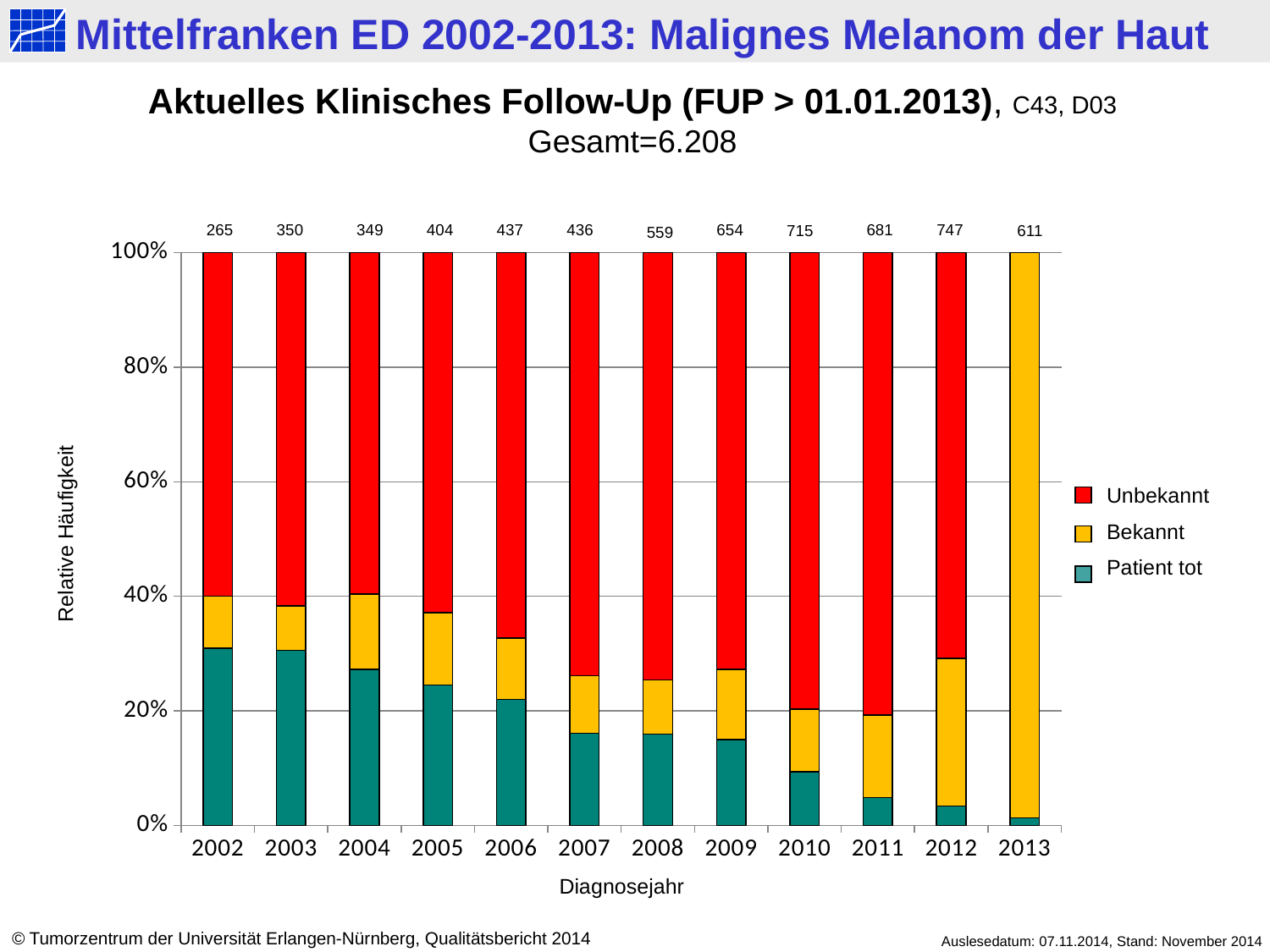
Which diagnosis year has the highest number printed above its bar? 2012 Which diagnosis year has the lowest number printed above its bar? 2002 What is the difference between the numbers printed above the bars for 2012 and 2002? 482 Does the share of 'Patient tot' rise or fall from 2002 to 2013? fall What is the number printed above the bar for 2002? 265 What is the number printed above the bar for 2009? 654 Is the share of 'Patient tot' in 2002 greater or less than 20%? greater How many diagnosis years are shown on the x axis? 12 What kind of chart is shown on the slide? Stacked bar chart Which year has the larger number printed above its bar, 2010 or 2011? 2010 How many series does the legend list? 3 Is the share of 'Patient tot' in 2012 greater or less than 20%? less